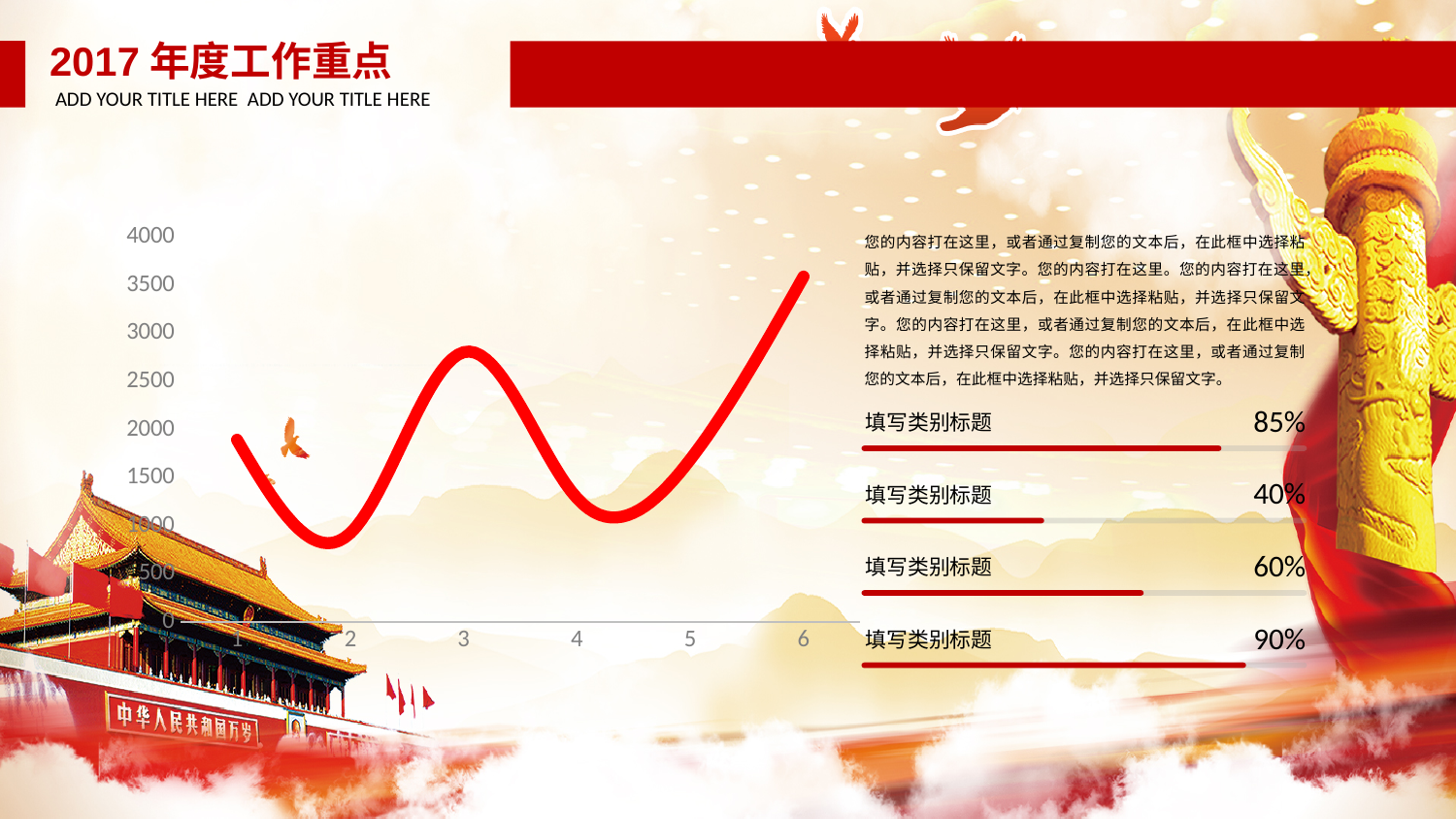
Which is larger on the line chart, the value at x = 3 or the value at x = 1? x = 3 Is the value at x = 2 on the line chart greater or less than 1500? less Is the value at x = 3 on the line chart greater or less than 2500? greater What is the highest value labelled on the y axis of the line chart? 4000 At which x-axis point does the line chart reach its highest value? 6 What kind of chart is shown on the slide? line chart Is the value at x = 6 on the line chart greater or less than 3000? greater Does the line rise or fall between x = 1 and x = 2? fall How many points are marked along the x axis of the line chart? 6 Does the line rise or fall between x = 5 and x = 6? rise